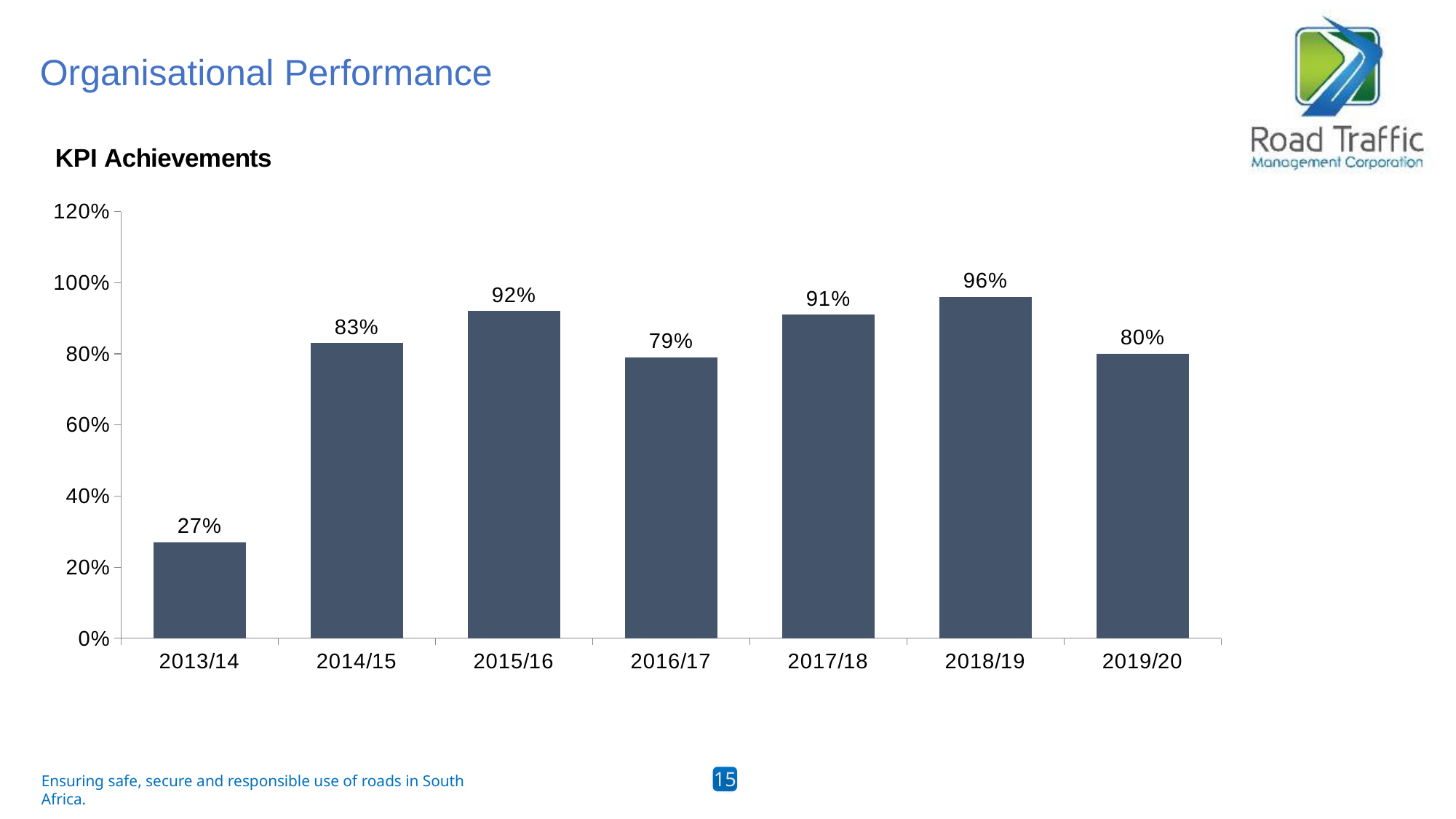
What kind of chart is shown on the slide? Bar chart How many years are shown on the x axis of the chart? 7 What is the difference between the KPI achievement in 2014/15 and 2013/14? 56% Which year has the highest KPI achievement? 2018/19 What is the difference between the KPI achievement in 2018/19 and 2019/20? 16% What is the KPI achievement value for 2019/20? 80% Which is larger, the KPI achievement for 2016/17 or for 2017/18? 2017/18 What is the title of the chart? KPI Achievements What is the KPI achievement value for 2013/14? 27% Which year has the lowest KPI achievement? 2013/14 What is the KPI achievement value for 2015/16? 92% Is the value for 2016/17 greater or less than 60%? greater